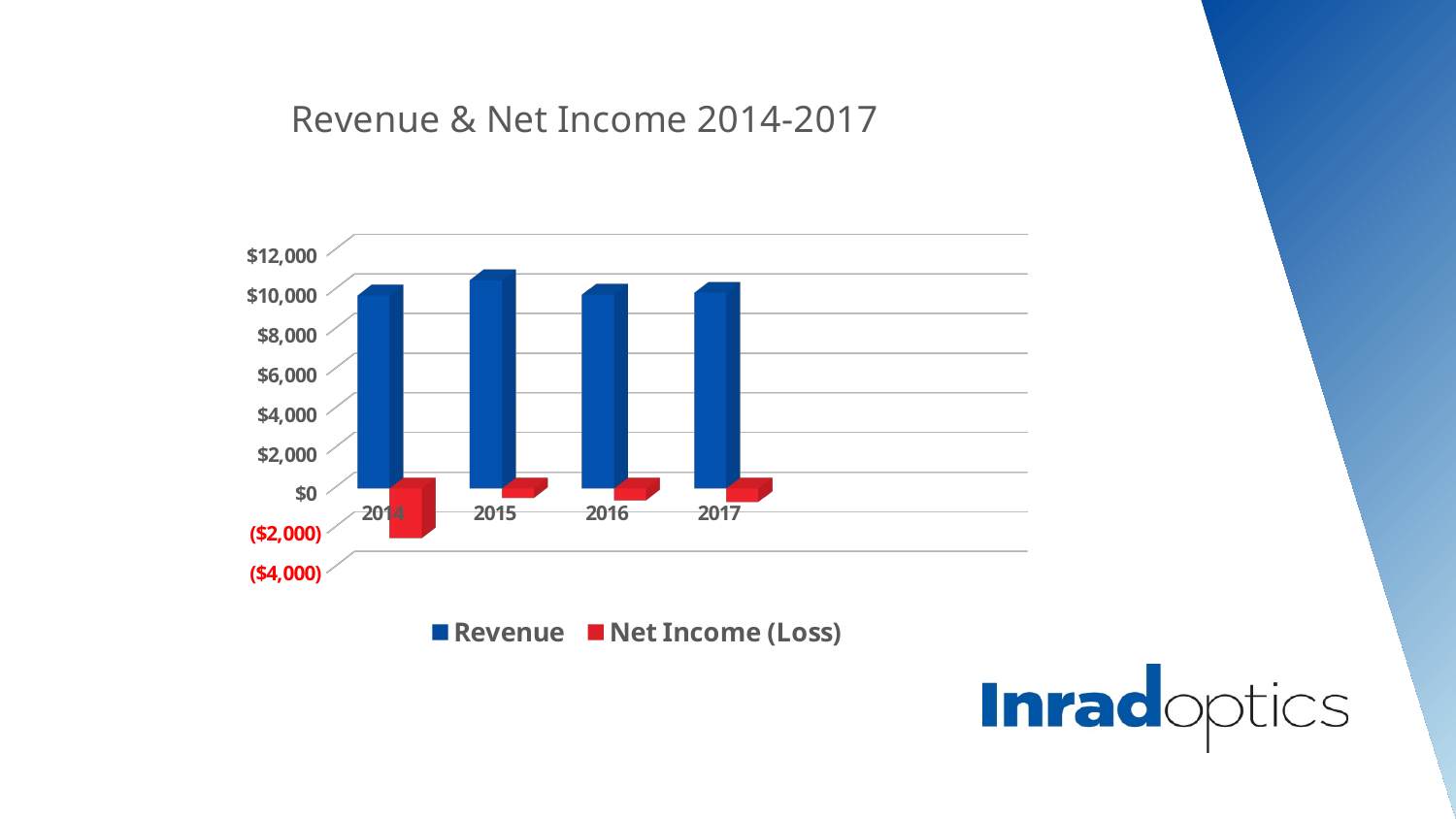
Which year has the lowest Net Income (Loss)? 2014 How many series does the legend list? 2 Which year has the highest Revenue? 2015 What kind of chart is shown on the slide? bar chart Is the Revenue for 2014 greater or less than $8,000? greater Which is larger, the Net Income (Loss) for 2015 or the Net Income (Loss) for 2014? 2015 How many years are shown on the x axis of the chart? 4 Is the Net Income (Loss) for 2014 greater or less than $0? less Which colour represents Net Income (Loss) in the chart? red Is the Revenue for 2015 greater or less than $10,000? greater Which is larger, the Revenue for 2015 or the Revenue for 2014? 2015 What is the title of the chart? Revenue & Net Income 2014-2017